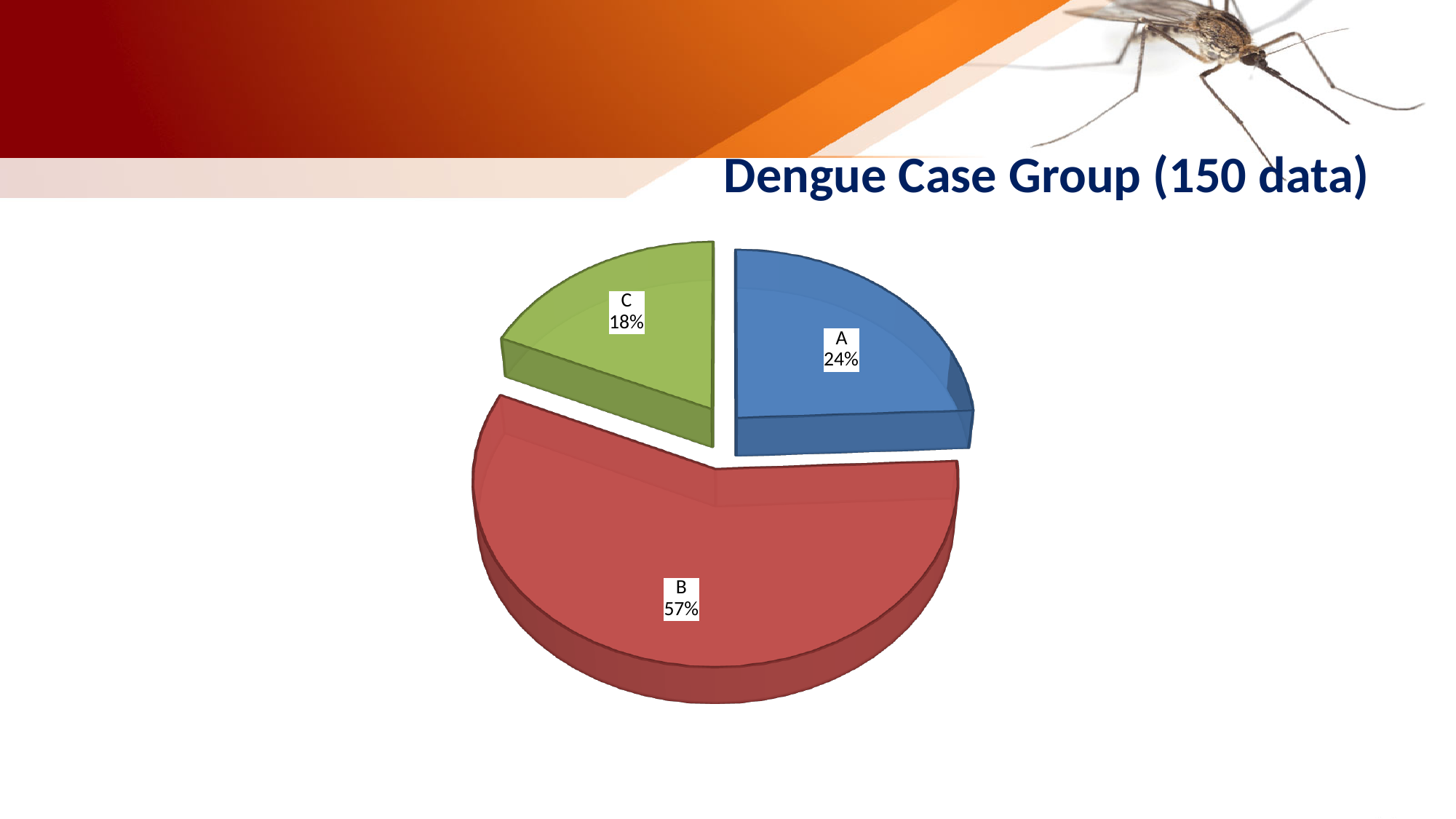
What share of the pie does group C have? 18% What is the title of the slide above the chart? Dengue Case Group (150 data) Which group has the smallest share of the pie? C What share of the pie does group B have? 57% What kind of chart is shown on the slide? pie chart What is the difference in percentage points between group B and group A? 33 How many slices does the pie chart have? 3 What is the difference in percentage points between group A and group C? 6 What share of the pie does group A have? 24% What colour is the slice for group B? red Which is larger, the share for group A or the share for group C? A Which group has the largest share of the pie? B